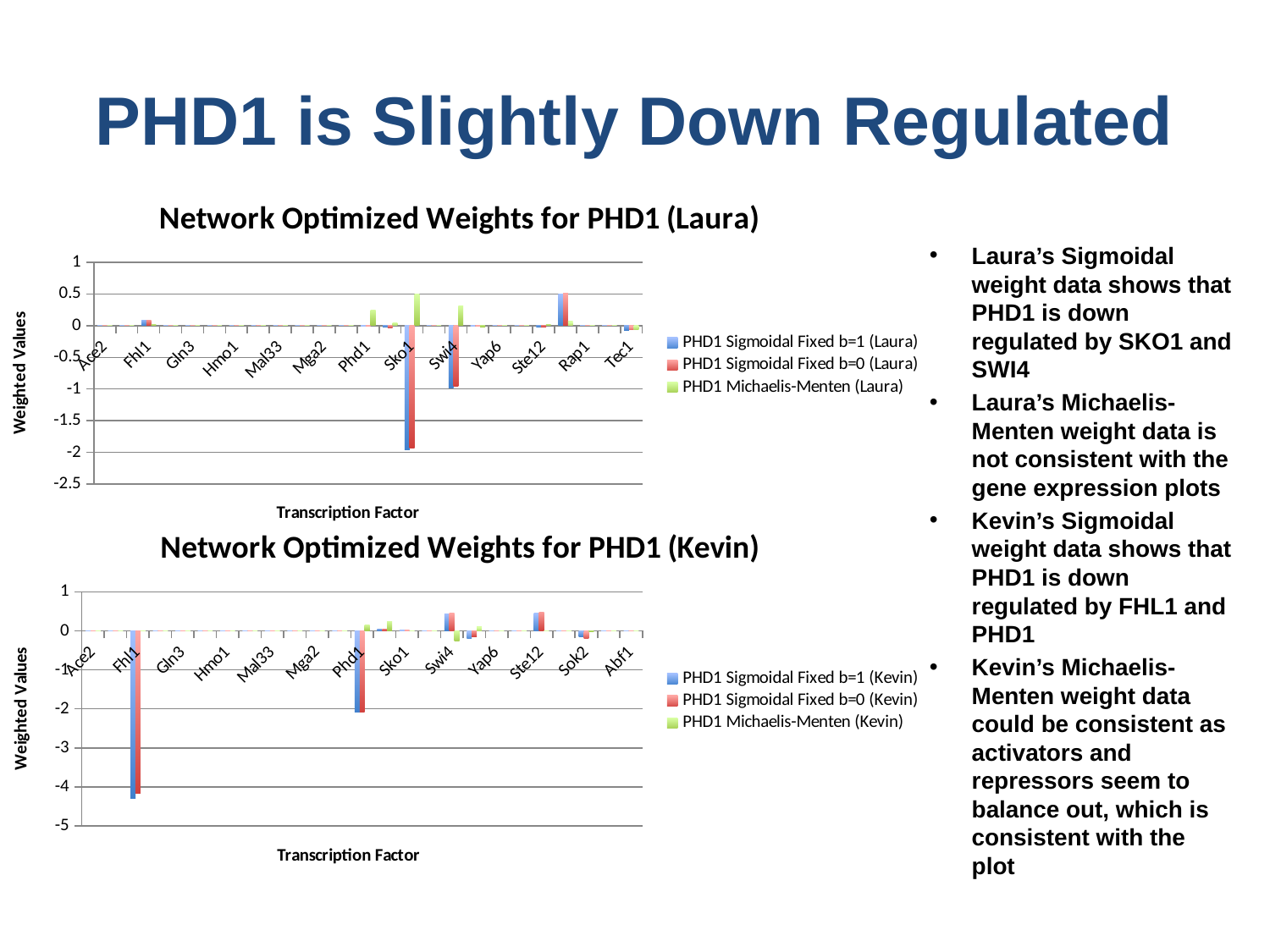
In "Network Optimized Weights for PHD1 (Laura)", which transcription factor has the lowest weighted value? Sko1 In "Network Optimized Weights for PHD1 (Kevin)", is the PHD1 Sigmoidal Fixed b=0 (Kevin) value for Phd1 greater or less than -1? less In "Network Optimized Weights for PHD1 (Kevin)", is the PHD1 Sigmoidal Fixed b=1 (Kevin) value for Fhl1 greater or less than -4? less In "Network Optimized Weights for PHD1 (Kevin)", which has the lower PHD1 Sigmoidal Fixed b=1 (Kevin) value, Fhl1 or Phd1? Fhl1 How many series does the legend of "Network Optimized Weights for PHD1 (Kevin)" list? 3 In "Network Optimized Weights for PHD1 (Kevin)", which transcription factor has the lowest weighted value? Fhl1 What is the y-axis title of "Network Optimized Weights for PHD1 (Laura)"? Weighted Values In "Network Optimized Weights for PHD1 (Laura)", is the PHD1 Michaelis-Menten (Laura) value for Sko1 greater or less than 0? greater What kind of chart is "Network Optimized Weights for PHD1 (Laura)"? bar chart In "Network Optimized Weights for PHD1 (Laura)", which has the lower PHD1 Sigmoidal Fixed b=0 (Laura) value, Sko1 or Swi4? Sko1 What is the x-axis title of "Network Optimized Weights for PHD1 (Kevin)"? Transcription Factor